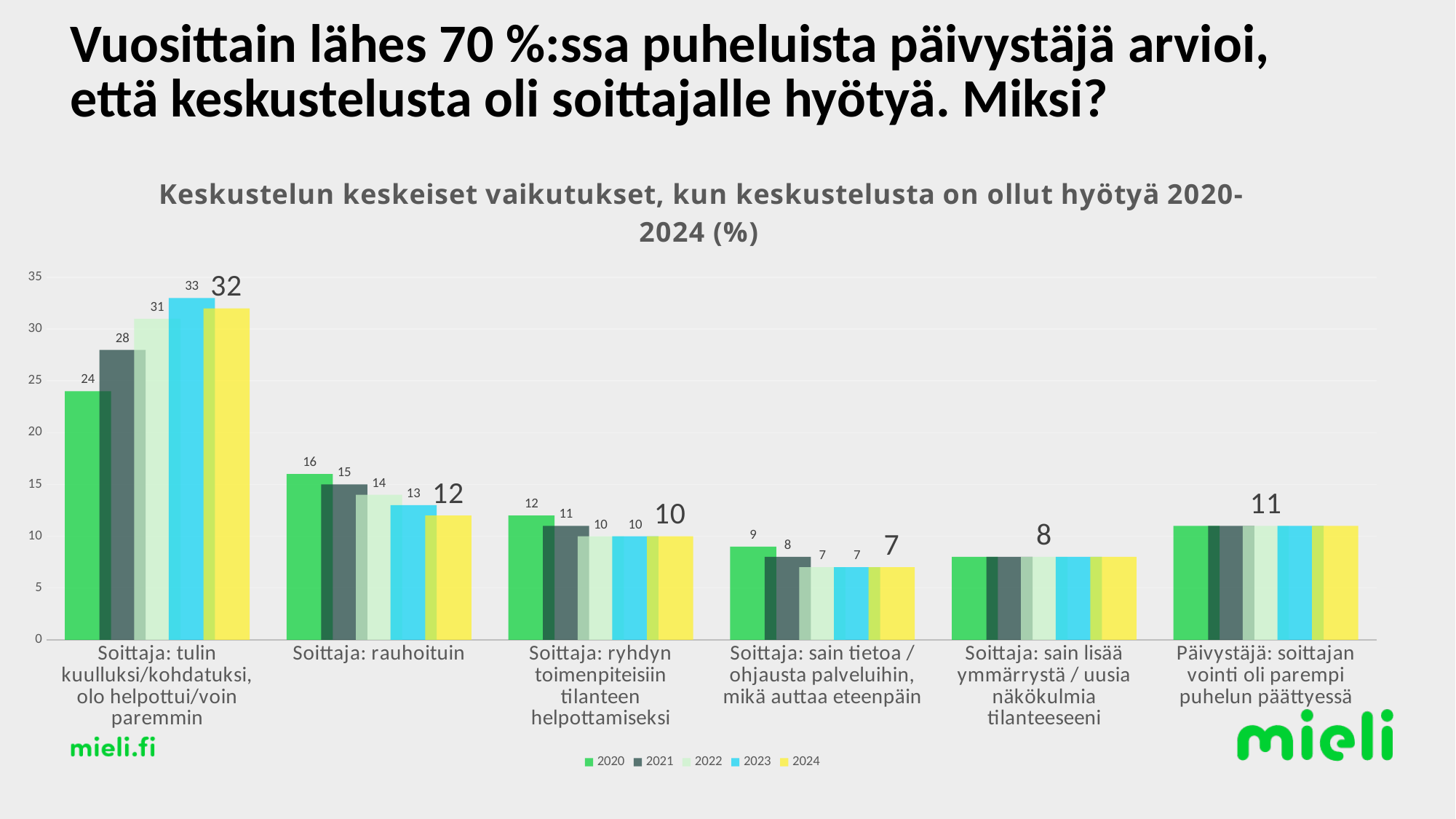
In the category "Soittaja: rauhoituin", which year has the larger value, 2020 or 2024? 2020 What is the value for 2020 in the category "Soittaja: rauhoituin"? 16 Which category has the highest value for 2024? Soittaja: tulin kuulluksi/kohdatuksi, olo helpottui/voin paremmin Which category has the lowest value for 2024? Soittaja: sain tietoa / ohjausta palveluihin, mikä auttaa eteenpäin Is the 2020 value for "Päivystäjä: soittajan vointi oli parempi puhelun päättyessä" greater or less than 10? greater What is the value for 2023 in the category "Soittaja: tulin kuulluksi/kohdatuksi, olo helpottui/voin paremmin"? 33 In the category "Soittaja: rauhoituin", do the values rise or fall from 2020 to 2024? fall How many series does the legend list? 5 What is the value for 2024 in the category "Soittaja: sain lisää ymmärrystä / uusia näkökulmia tilanteeseeni"? 8 How many categories are shown on the x axis? 6 What kind of chart is shown on the slide? bar chart In the category "Soittaja: tulin kuulluksi/kohdatuksi, olo helpottui/voin paremmin", how much higher is the 2023 value than the 2020 value? 9